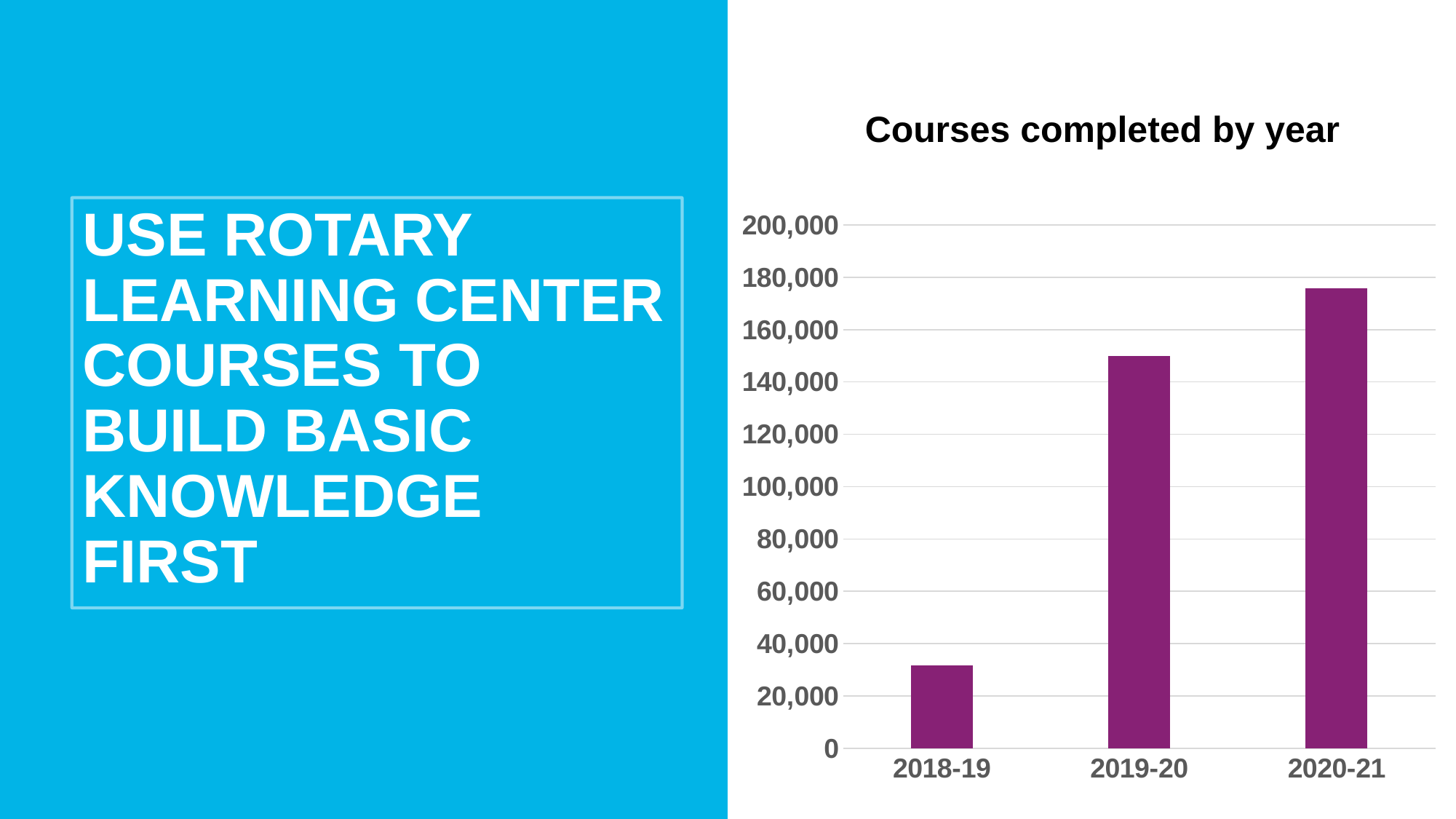
Is the value for 2018-19 greater or less than 40,000? less Which year has the lowest number of courses completed? 2018-19 Which year has the highest number of courses completed? 2020-21 What is the maximum value shown on the y axis of the chart? 200,000 What is the title of the chart? Courses completed by year Do the values rise or fall from 2018-19 to 2020-21? rise How many years are shown on the x axis of the chart? 3 What kind of chart is shown on the slide? bar chart Is the value for 2020-21 greater or less than 160,000? greater Is the value for 2019-20 greater or less than 140,000? greater Which is larger, the value for 2018-19 or the value for 2019-20? 2019-20